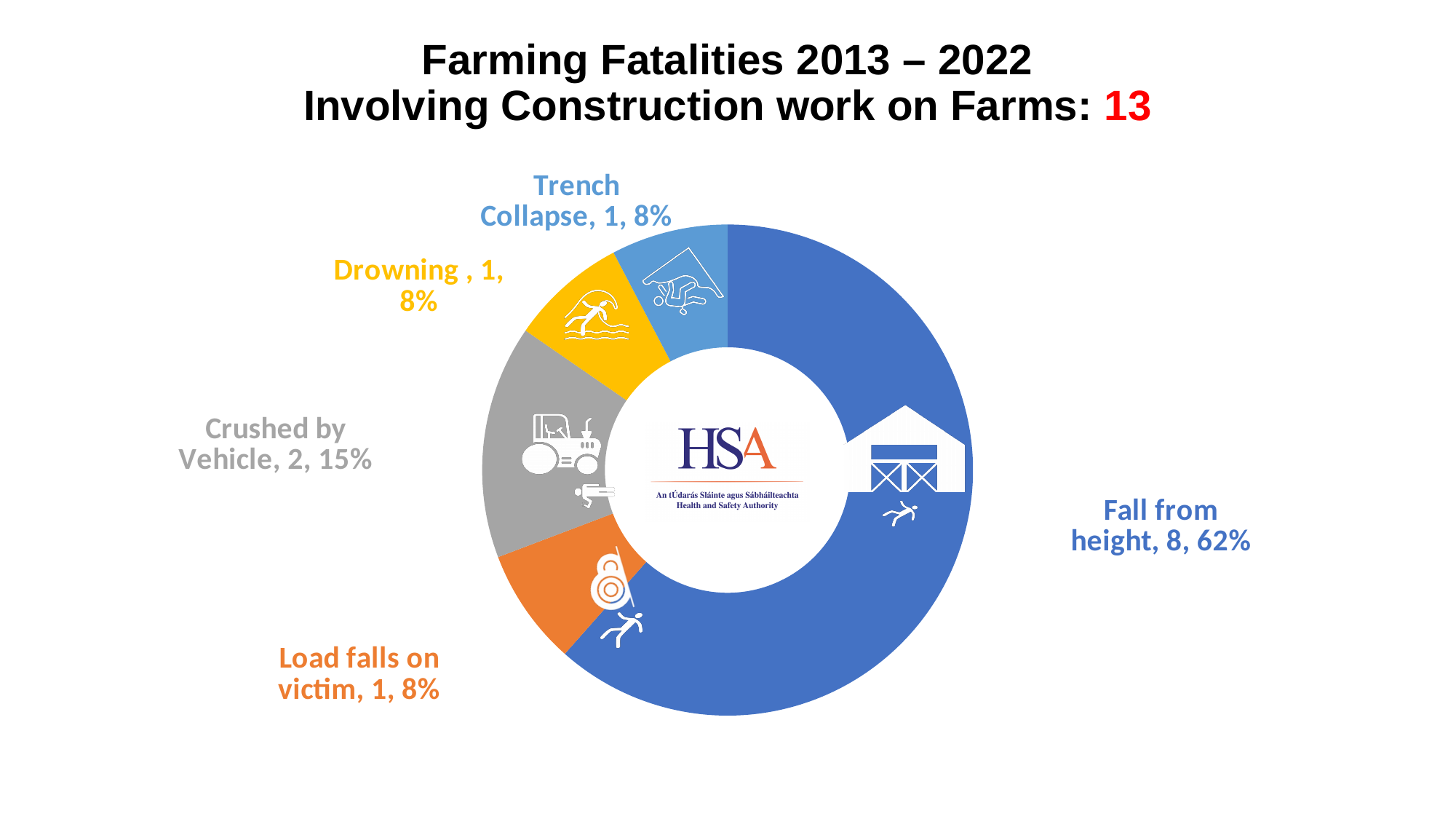
What percentage share does Crushed by Vehicle have? 15% How many fatalities are shown for Fall from height? 8 What is the difference in fatalities between Fall from height and Crushed by Vehicle? 6 What is the total number of fatalities stated in the chart title? 13 What kind of chart is shown on the slide? Pie chart (doughnut) Which is larger, the number of fatalities from Crushed by Vehicle or from Trench Collapse? Crushed by Vehicle How many fatalities are shown for Load falls on victim? 1 What share of the pie does Fall from height represent? 62% What colour is the Drowning slice? Yellow How many categories are shown in the chart? 5 Which category has the highest number of fatalities? Fall from height How many fatalities are attributed to Drowning? 1